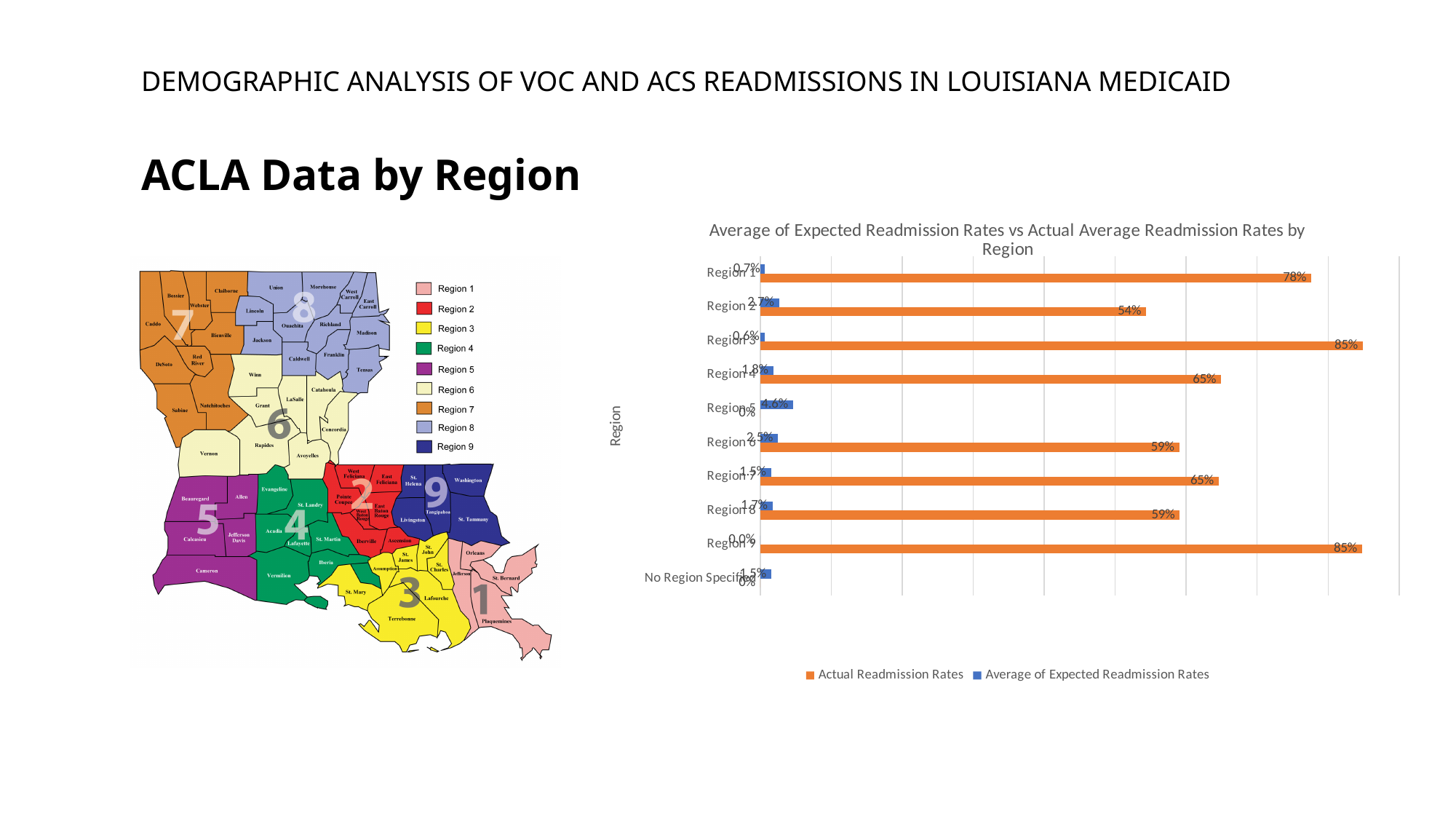
How many categories are shown on the y axis of the chart? 10 What is the Actual Readmission Rate for Region 1? 78% Which series is shown in orange in the chart? Actual Readmission Rates Which has a higher Actual Readmission Rate, Region 1 or Region 4? Region 1 What is the Actual Readmission Rate for Region 6? 59% What is the difference between the Actual Readmission Rates of Region 3 and Region 2? 31% What is the Average of Expected Readmission Rates for Region 5? 4.6% How many series does the chart's legend list? 2 Which region has the highest Average of Expected Readmission Rates? Region 5 Which region has the lowest Average of Expected Readmission Rates? Region 9 What kind of chart is shown on the slide? Bar chart What is the Actual Readmission Rate for Region 2? 54%